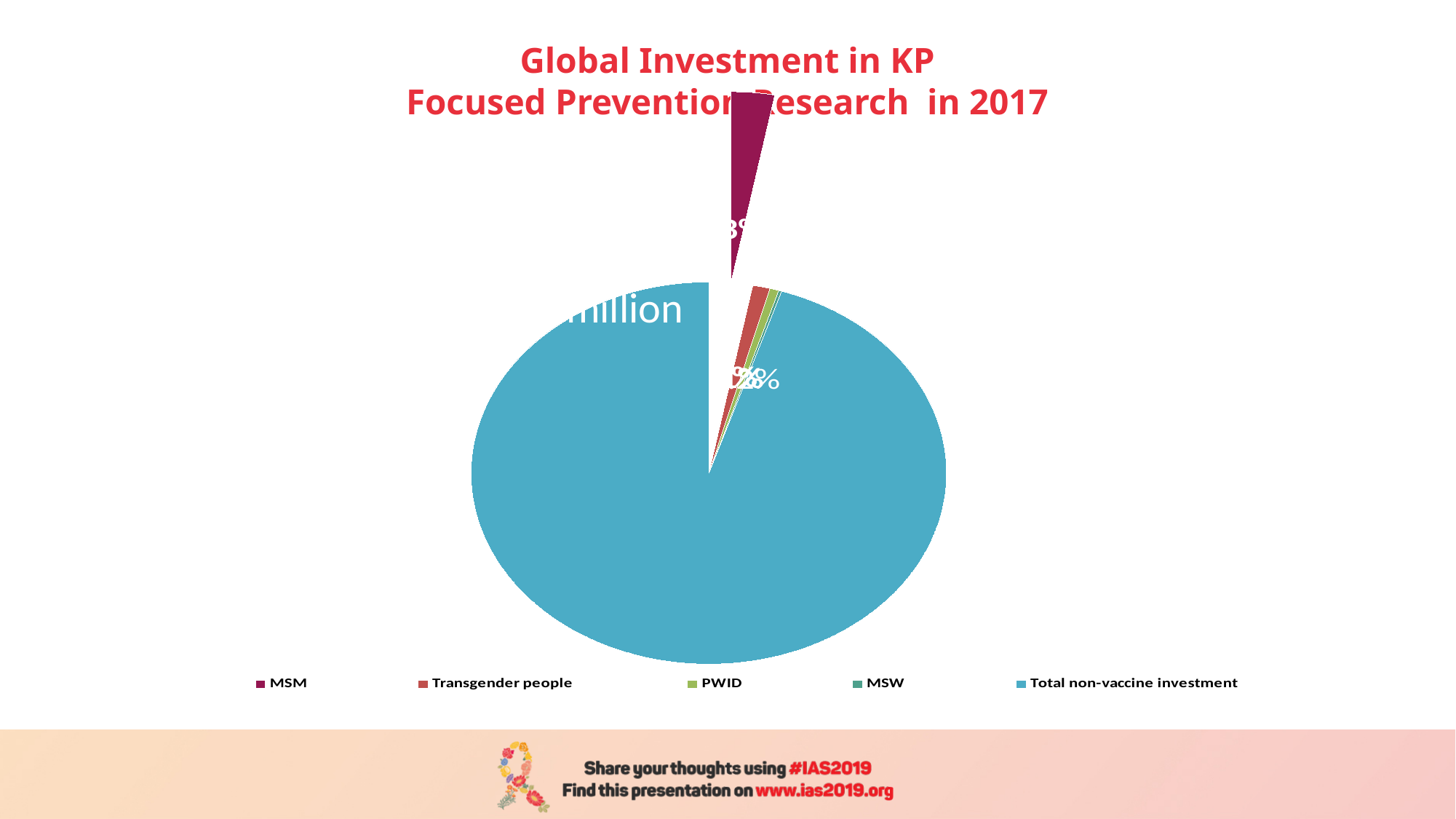
What is the title of the pie chart? Global Investment in KP Focused Prevention Research in 2017 How many categories does the legend of the pie chart list? 5 What kind of chart is shown on the slide? Pie chart Which legend entry is shown in blue on the pie chart? Total non-vaccine investment Which slice is larger, Total non-vaccine investment or MSM? Total non-vaccine investment Which category has the largest slice of the pie chart? Total non-vaccine investment Which slice is larger, MSM or Transgender people? MSM Which slice is larger, Transgender people or PWID? Transgender people